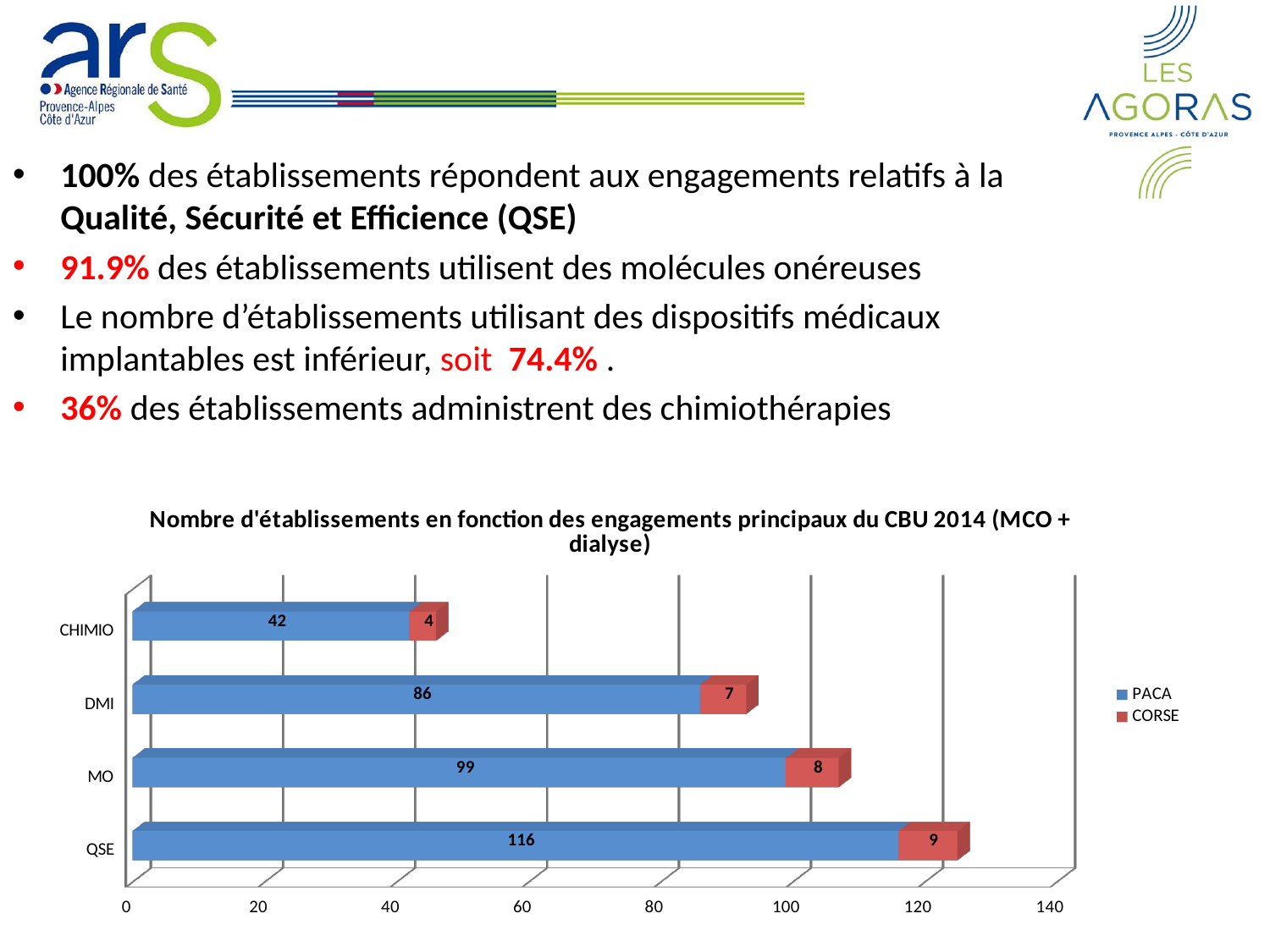
How many categories are shown on the chart? 4 What is the CORSE value for DMI? 7 How many series does the legend list? 2 What is the PACA value for CHIMIO? 42 What is the difference between the PACA values for MO and DMI? 13 Which category has the lowest CORSE value? CHIMIO Which category has the highest PACA value? QSE What is the PACA value for QSE? 116 What kind of chart is shown on the slide? Stacked bar chart What is the total of the stacked bar for MO? 107 Which is larger, the PACA value for DMI or the PACA value for CHIMIO? DMI What is the total of the stacked bar for QSE? 125